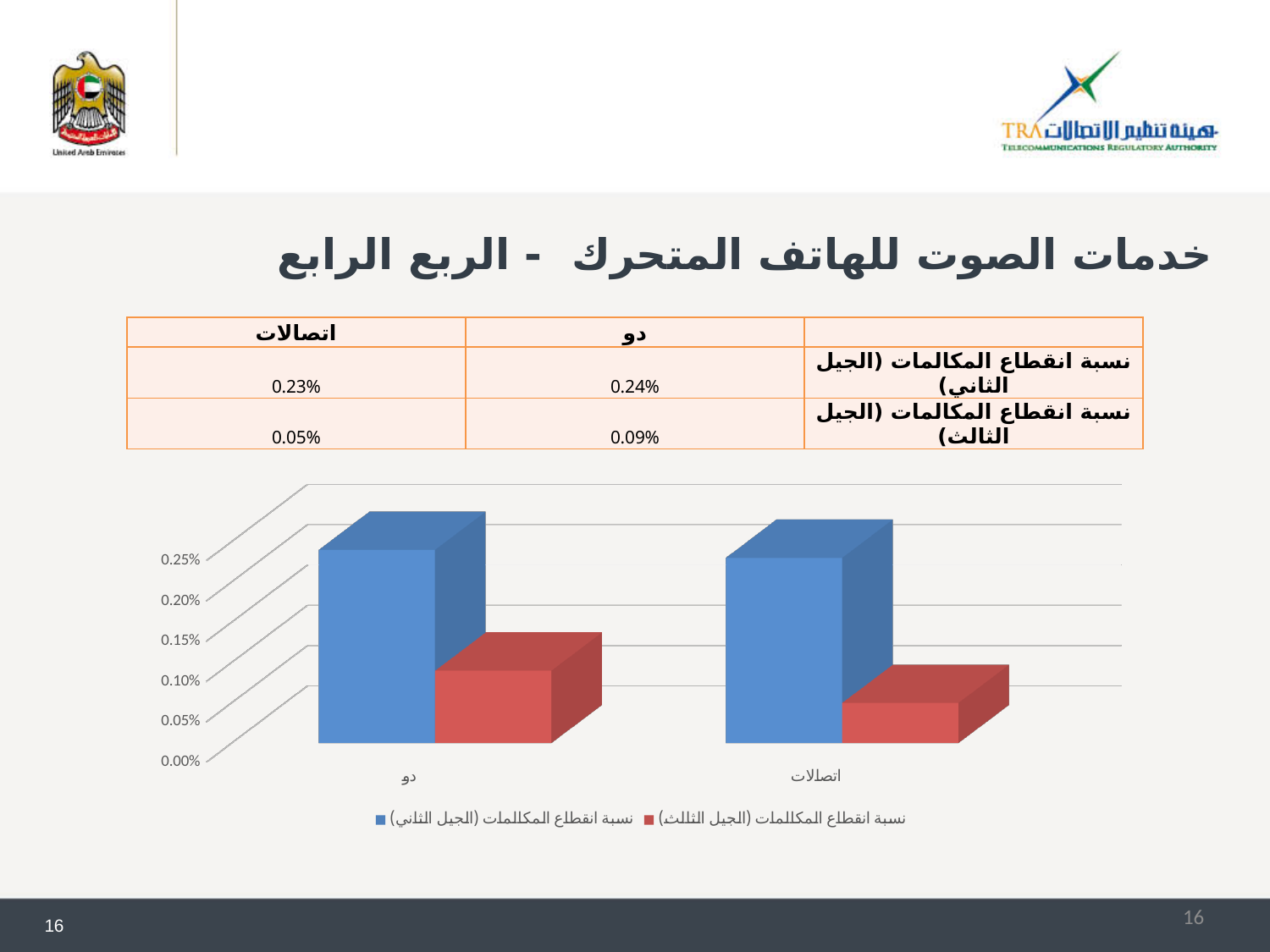
Is the second generation (الجيل الثاني) call drop rate for دو greater or less than 0.20%? greater What is the call drop rate for the second generation (الجيل الثاني) for دو? 0.24% Which colour represents the second generation (الجيل الثاني) call drop rate series in the chart? blue What kind of chart is shown on the slide? bar chart Which bar in the chart is the lowest? اتصالات, نسبة انقطاع المكالمات (الجيل الثالث) Is the third generation (الجيل الثالث) call drop rate for اتصالات greater or less than 0.10%? less How many categories (operators) are shown on the x axis of the chart? 2 Which operator has the lower third generation (الجيل الثالث) call drop rate, دو or اتصالات? اتصالات What is the call drop rate for the third generation (الجيل الثالث) for اتصالات? 0.05% How many series does the chart legend list? 2 What is the call drop rate for the third generation (الجيل الثالث) for دو? 0.09% What is the difference between the second generation and third generation call drop rates for اتصالات? 0.18%